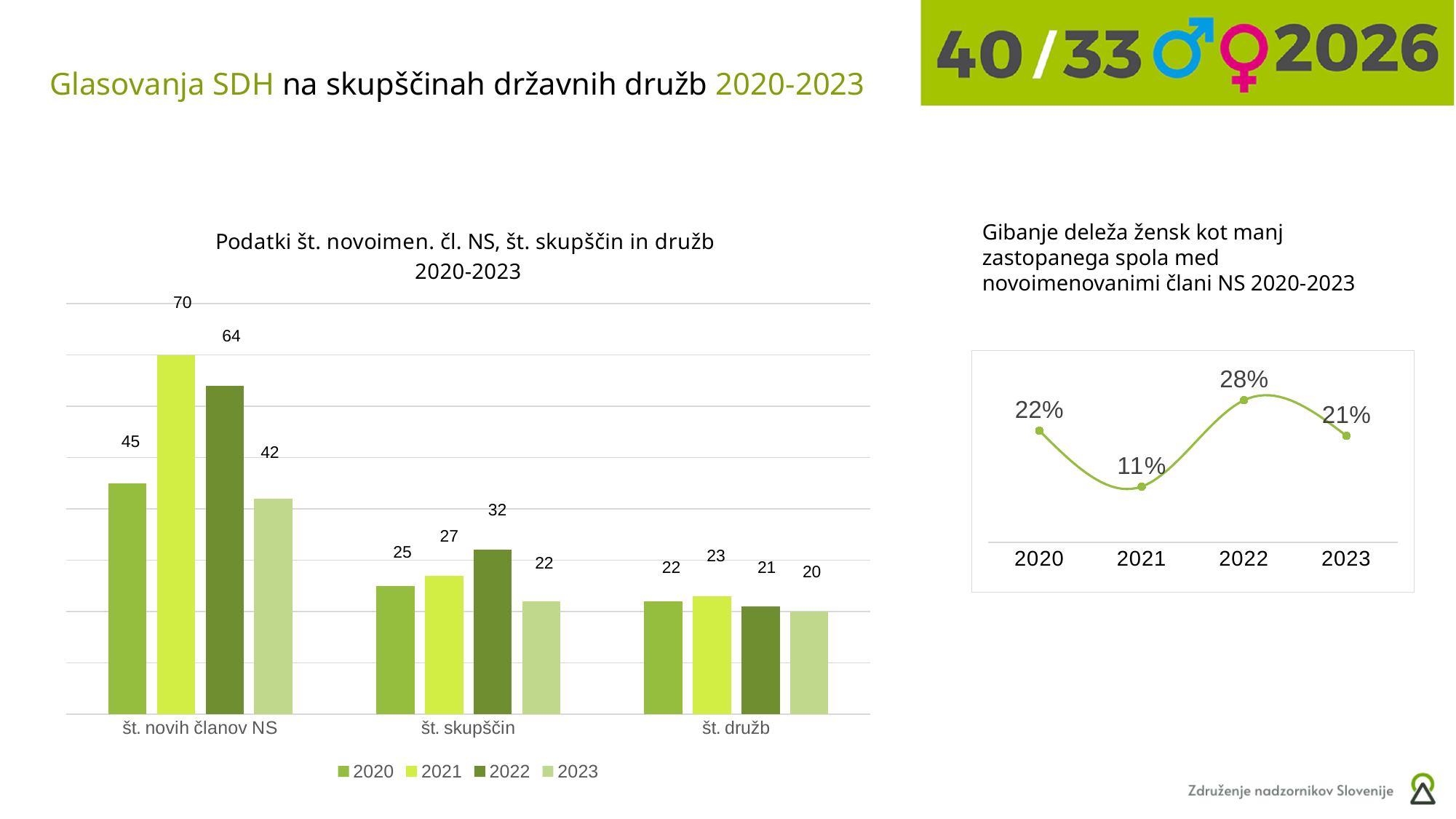
In the line chart on the right, which year has the highest value? 2022 In the bar chart on the left, which year has the lowest value in the 'št. družb' category? 2023 In the bar chart on the left, what is the value for 2023 in the 'št. skupščin' category? 22 How many series does the legend of the bar chart on the left list? 4 In the bar chart on the left, which is larger for 'št. družb': the 2020 value or the 2021 value? 2021 In the bar chart on the left, which year has the highest value in the 'št. skupščin' category? 2022 In the line chart on the right, what is the difference between the 2022 and 2021 values? 17% What kind of chart is the chart on the left? bar chart In the line chart on the right, what is the value for 2021? 11% How many categories are shown on the x axis of the bar chart on the left? 3 In the bar chart on the left, what is the value for 2021 in the 'št. novih članov NS' category? 70 In the bar chart on the left, what is the difference between the 2021 and 2020 values for 'št. novih članov NS'? 25